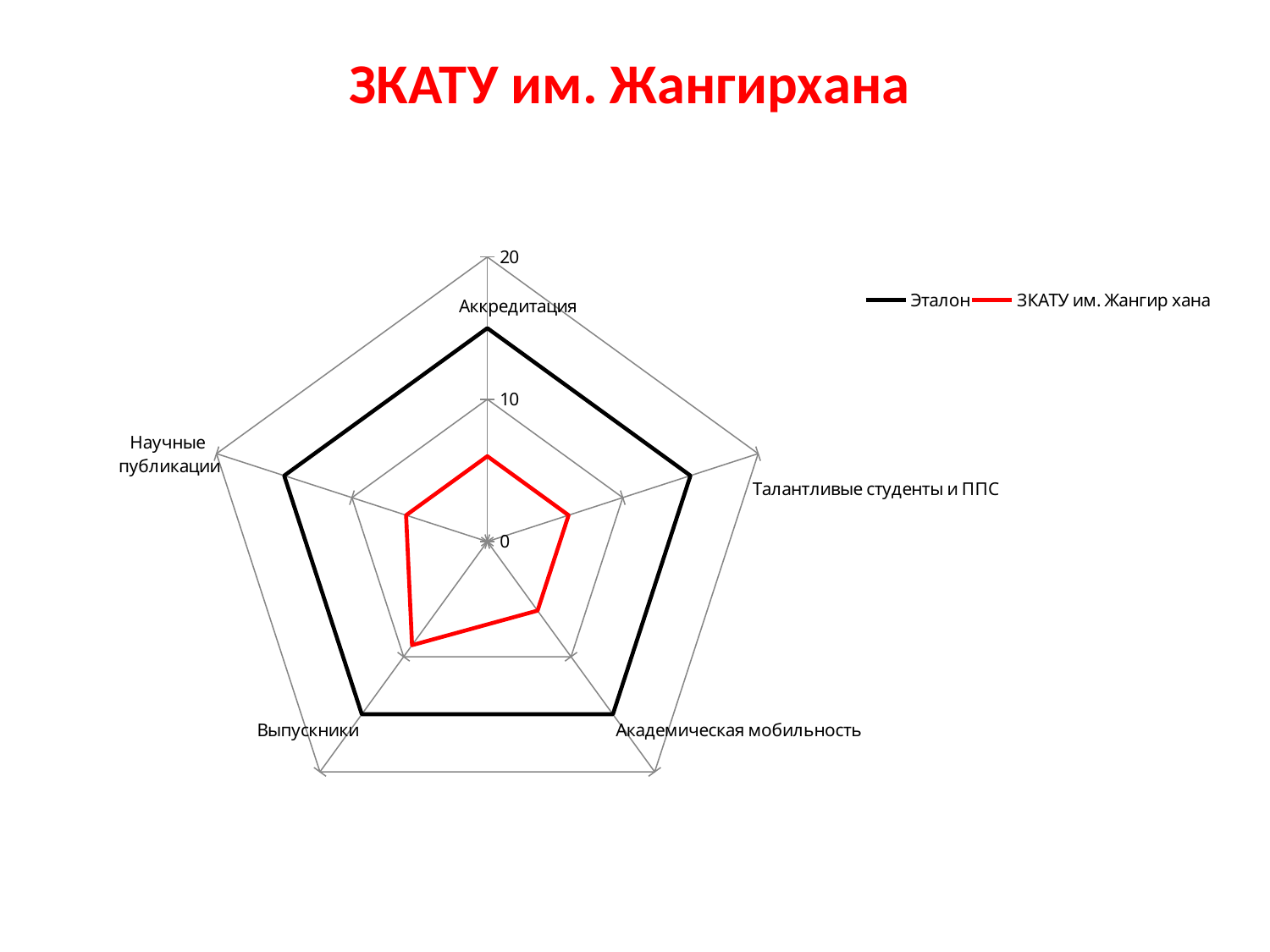
Is the value of ЗКАТУ им. Жангир хана for Аккредитация greater or less than 10? less Which series is drawn with the red line? ЗКАТУ им. Жангир хана Is the value of ЗКАТУ им. Жангир хана for Выпускники greater or less than 10? less For which category does ЗКАТУ им. Жангир хана have its highest value? Выпускники How many series does the legend list? 2 How many categories (axes) does the radar chart have? 5 For Научные публикации, which series has the larger value, Эталон or ЗКАТУ им. Жангир хана? Эталон Is the value of Эталон for Академическая мобильность greater or less than 20? less What kind of chart is shown on the slide? radar chart What colour is the line for the Эталон series? black For ЗКАТУ им. Жангир хана, which is larger: the value for Выпускники or the value for Аккредитация? Выпускники